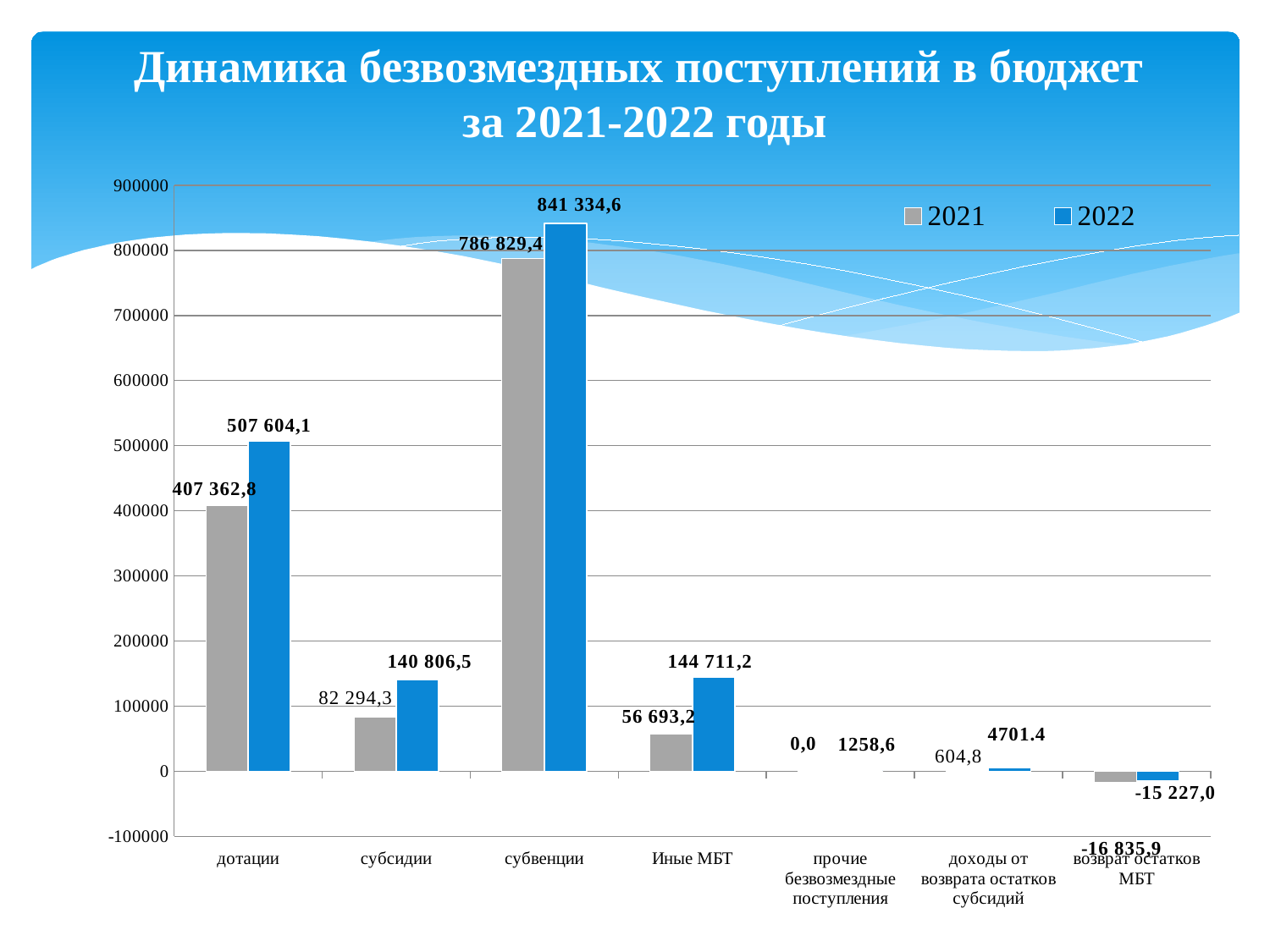
What is the value for дотации in 2021? 407 362,8 How many series does the legend list? 2 What is the value for возврат остатков МБТ in 2021? -16 835,9 How many categories are shown on the x axis? 7 What is the value for субвенции in 2022? 841 334,6 Which category has the lowest value in 2021? возврат остатков МБТ What is the difference between the 2022 and 2021 values for субвенции? 54 505,2 Which is larger for субсидии: the 2021 value or the 2022 value? 2022 Which category has the highest value in 2022? субвенции What is the value for Иные МБТ in 2022? 144 711,2 What kind of chart is shown on the slide? bar chart What is the difference between the 2022 and 2021 values for дотации? 100 241,3